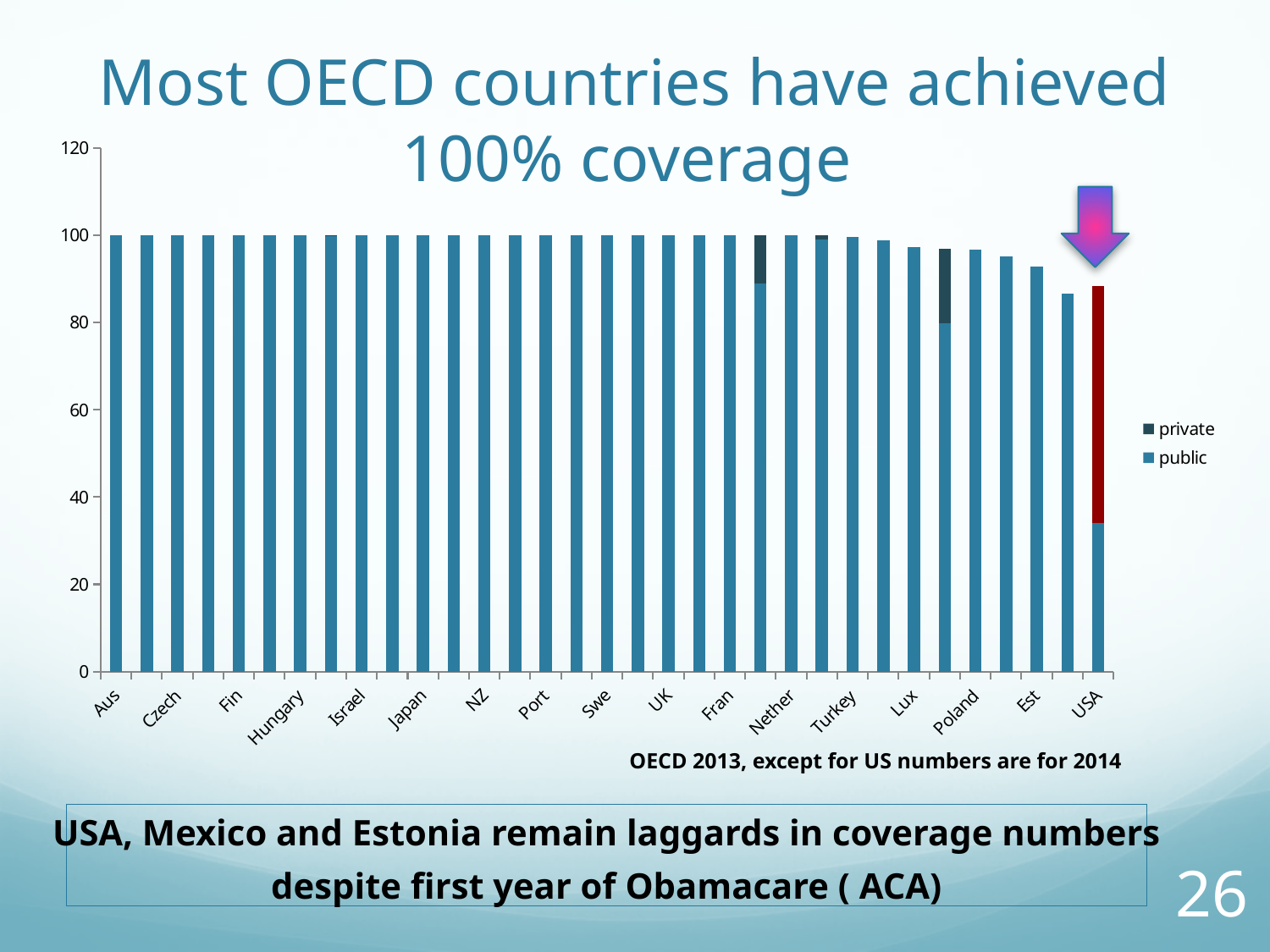
What are the two series named in the legend? private and public Is the value for Aus greater or less than 80? greater Do the bar totals generally rise or fall moving from left to right along the x axis? fall Is the total value for USA greater or less than 100? less What is the title of the chart? Most OECD countries have achieved 100% coverage How many series does the legend list? 2 Is the value for Est greater or less than 100? less Which has the larger public coverage, UK or USA? UK What kind of chart is shown on the slide? bar chart Which has the larger total coverage, Aus or USA? Aus Which country has the lowest public coverage value? USA